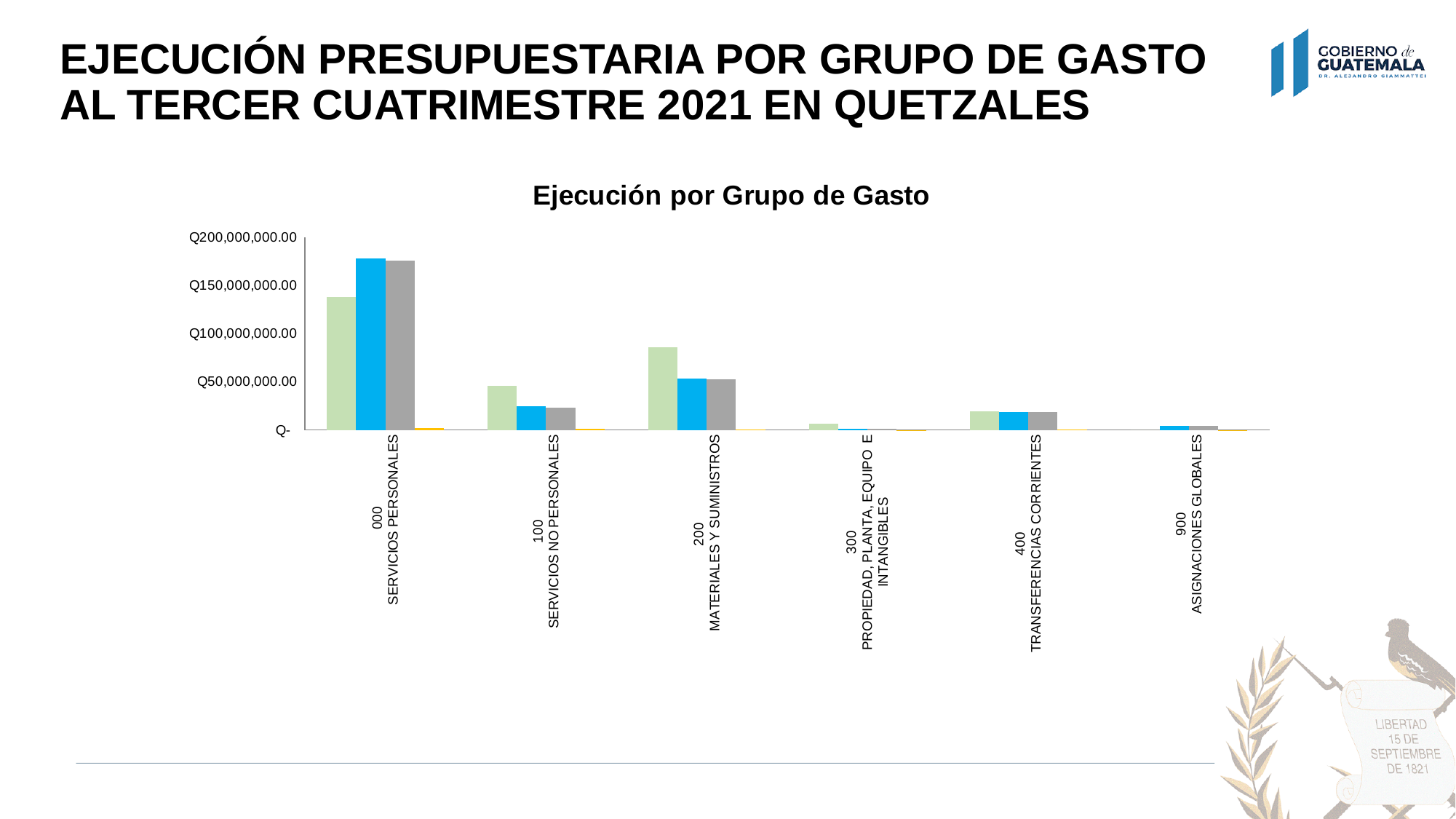
What is the title of the chart? Ejecución por Grupo de Gasto Which category has the tallest bars in the chart? 000 SERVICIOS PERSONALES Is the value of the blue bar for 100 SERVICIOS NO PERSONALES greater or less than Q50,000,000.00? less Which has a larger blue bar: 000 SERVICIOS PERSONALES or 400 TRANSFERENCIAS CORRIENTES? 000 SERVICIOS PERSONALES What kind of chart is shown on the slide? Bar chart What is the highest value labelled on the vertical axis of the chart? Q200,000,000.00 Is the value of the blue bar for 000 SERVICIOS PERSONALES greater or less than Q150,000,000.00? greater Is the value of the green bar for 200 MATERIALES Y SUMINISTROS greater or less than Q50,000,000.00? greater How many expense group categories are shown on the x axis of the chart? 6 Which has a larger green bar: 100 SERVICIOS NO PERSONALES or 200 MATERIALES Y SUMINISTROS? 200 MATERIALES Y SUMINISTROS